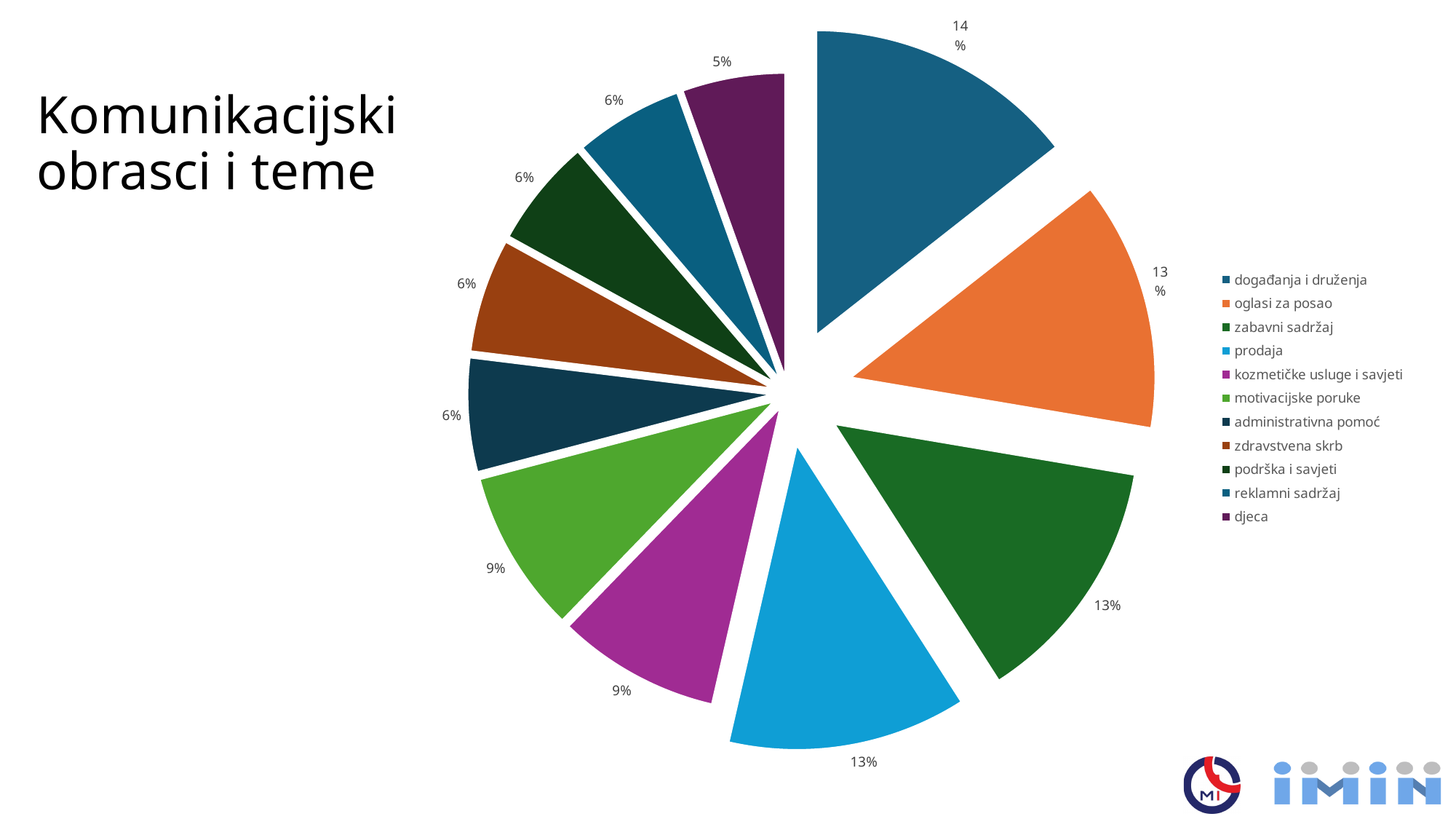
What colour is the slice for 'oglasi za posao'? orange What is the value shown for 'motivacijske poruke'? 9% What is the value shown for 'oglasi za posao'? 13% What share of the pie does 'događanja i druženja' have? 14% What is the title of the slide with the pie chart? Komunikacijski obrasci i teme What is the value shown for 'djeca'? 5% Which category has the largest share of the pie? događanja i druženja What type of chart is shown on the slide? pie chart Which category has the smallest share of the pie? djeca How many slices does the pie chart have? 11 Which has a larger share, 'prodaja' or 'kozmetičke usluge i savjeti'? prodaja What is the difference between the shares of 'događanja i druženja' and 'djeca'? 9%